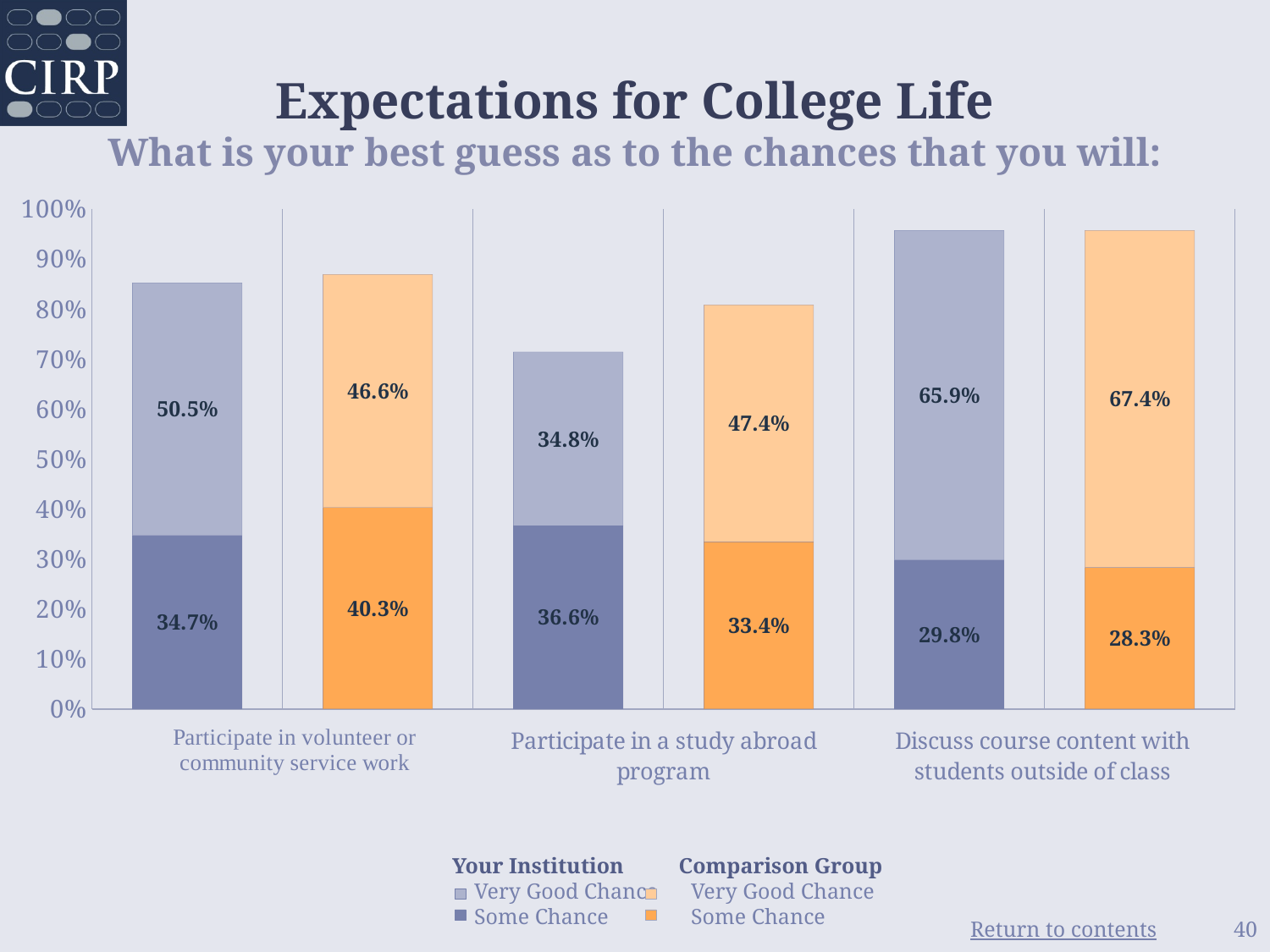
How many series does the legend list? 4 What is the combined total of the Comparison Group bar for participating in volunteer or community service work? 86.9% What is the difference between the Your Institution Very Good Chance values for discussing course content outside of class and participating in a study abroad program? 31.1 percentage points What kind of chart is shown on the slide? Stacked bar chart What percentage of Your Institution students said there is a Very Good Chance they will participate in volunteer or community service work? 50.5% How many categories (questions) are shown on the x axis of the chart? 3 What is the Your Institution Very Good Chance value for discussing course content with students outside of class? 65.9% What is the combined total (Very Good Chance plus Some Chance) of the Your Institution bar for participating in a study abroad program? 71.4% For the Comparison Group, which category has the lowest Some Chance value? Discuss course content with students outside of class For participating in a study abroad program, which group has the larger Very Good Chance value, Your Institution or the Comparison Group? Comparison Group What is the Comparison Group's Some Chance value for participating in a study abroad program? 33.4% For Your Institution, which category has the highest Very Good Chance value? Discuss course content with students outside of class